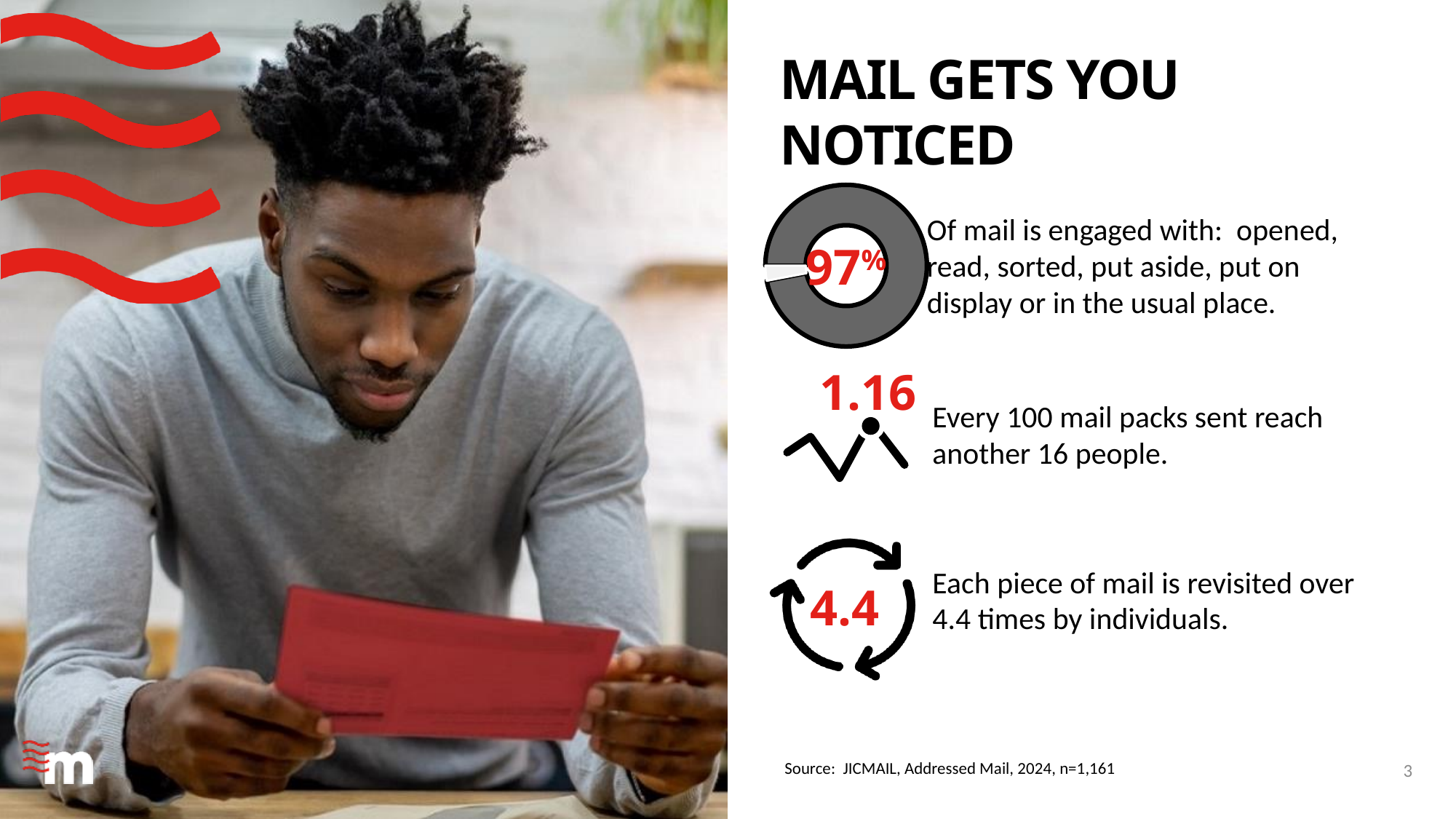
How many slices does the donut chart have? 2 What is the title of the slide containing the donut chart? MAIL GETS YOU NOTICED What share of mail does the donut chart show is engaged with? 97% What percentage is shown in the centre of the donut chart? 97% What colour is the large slice of the donut chart? Grey What kind of chart is used to show the 97% figure? Donut (pie) chart Is the value shown in the donut chart greater or less than 90%? greater